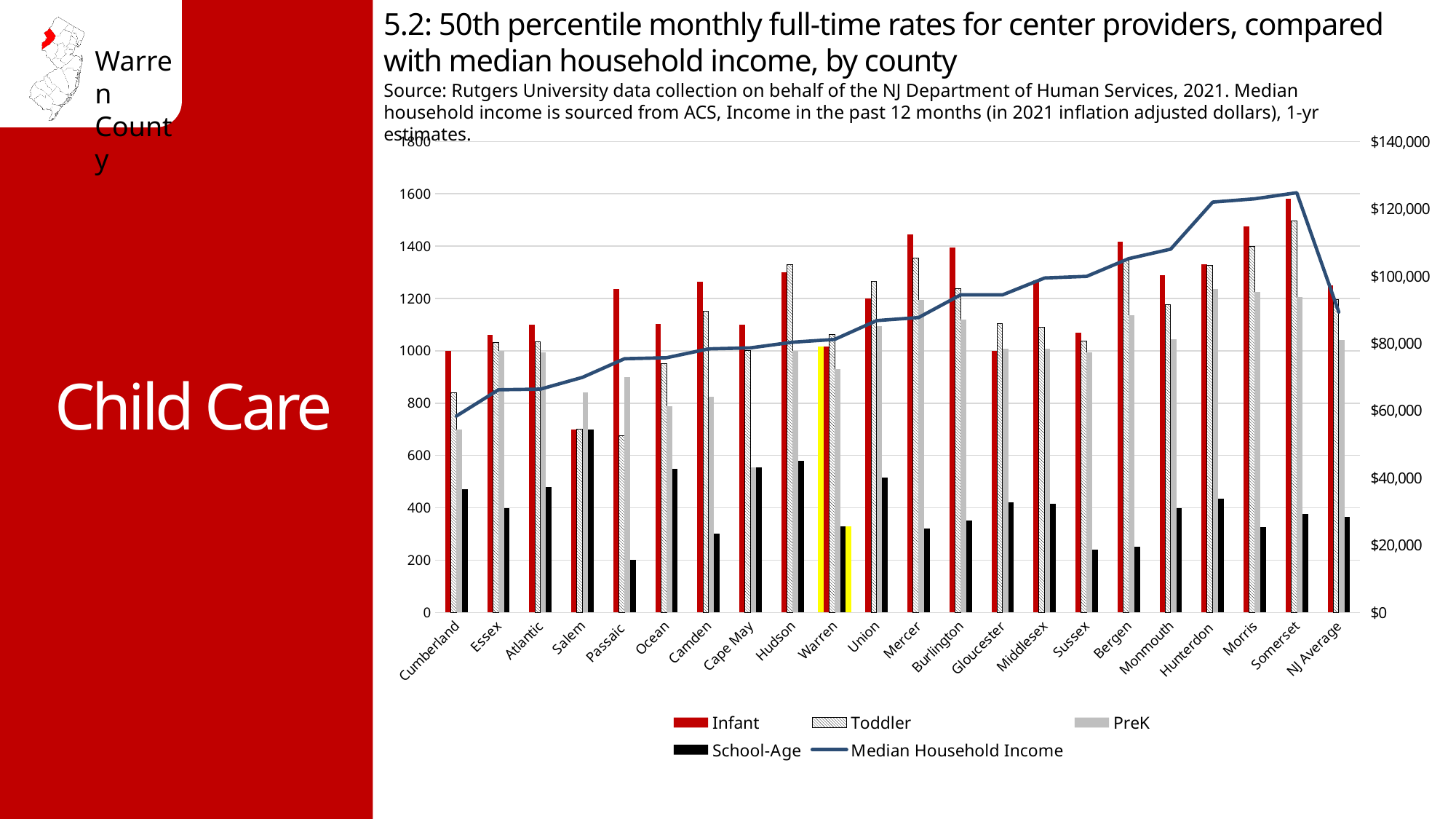
Which county has the lowest School-Age rate? Passaic Which county has the lowest Infant rate? Salem Is the School-Age rate for Passaic greater or less than 400? less What kind of chart is shown on the slide? A bar chart with a line (combination chart) Which county has the highest School-Age rate? Salem How many categories are shown along the x axis of the chart? 22 How many series does the chart's legend list? 5 Does the Median Household Income line generally rise or fall from Cumberland to Somerset? rise Which county's bars are highlighted in yellow on the chart? Warren Which county has the highest Infant rate? Somerset Is the Infant rate for Somerset greater or less than 1400? greater Which county has the lowest Median Household Income on the line? Cumberland